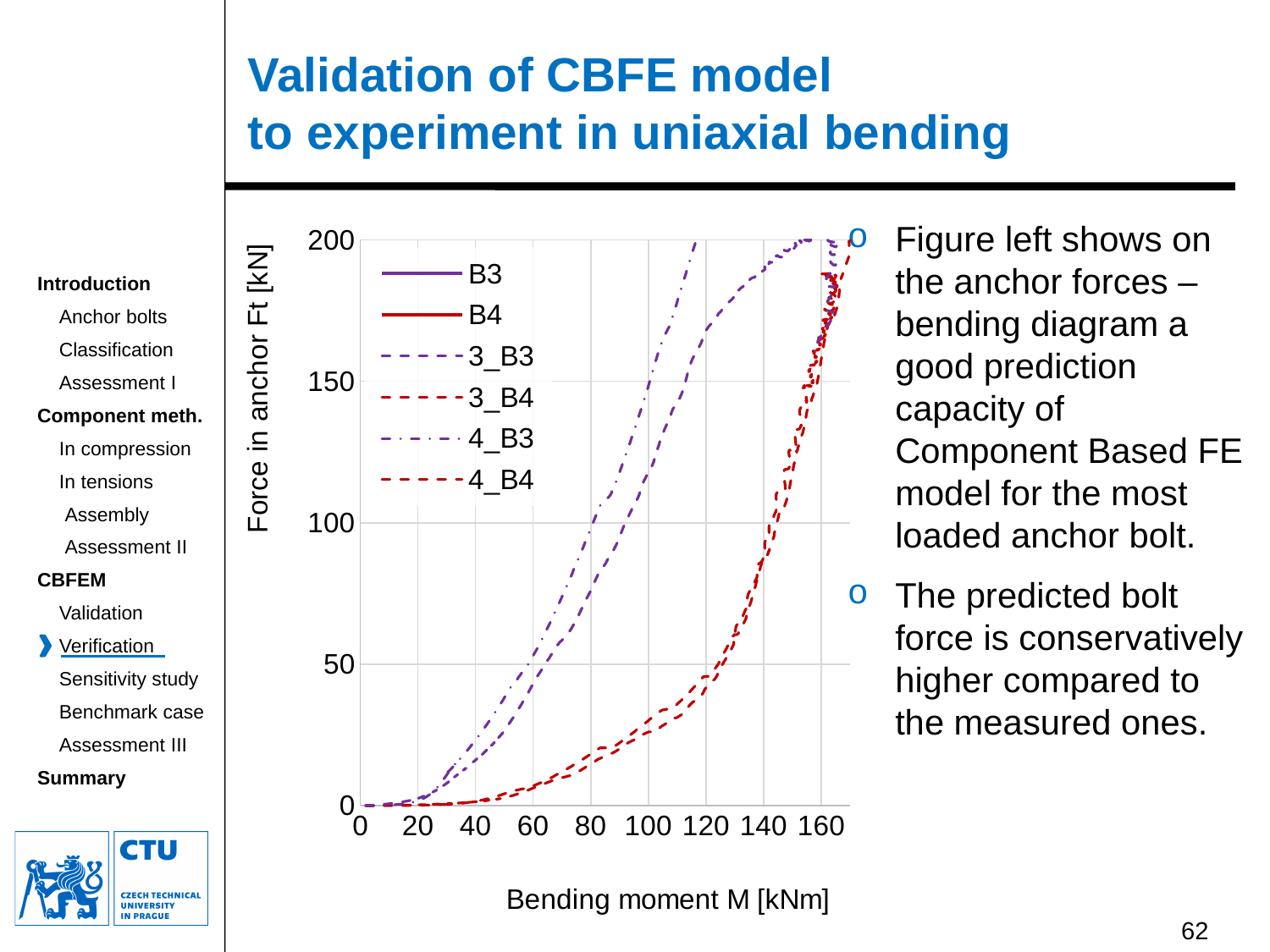
Do the plotted anchor forces rise or fall as the bending moment increases along the x axis? rise What kind of chart is shown on the slide? line chart What is the highest value shown on the y axis of the chart? 200 At a bending moment of 100 kNm, which series has the larger anchor force, 4_B3 or 4_B4? 4_B3 Is the value of the 4_B3 series at a bending moment of 100 kNm greater or less than 100 kN? greater What is the label of the x axis of the chart? Bending moment M [kNm] Which series reaches an anchor force of 200 kN at the lowest bending moment? 4_B3 Is the value of the 3_B3 series at a bending moment of 120 kNm greater or less than 150 kN? greater What is the label of the y axis of the chart? Force in anchor Ft [kN] How many series does the chart legend list? 6 Is the value of the 3_B4 series at a bending moment of 80 kNm greater or less than 50 kN? less